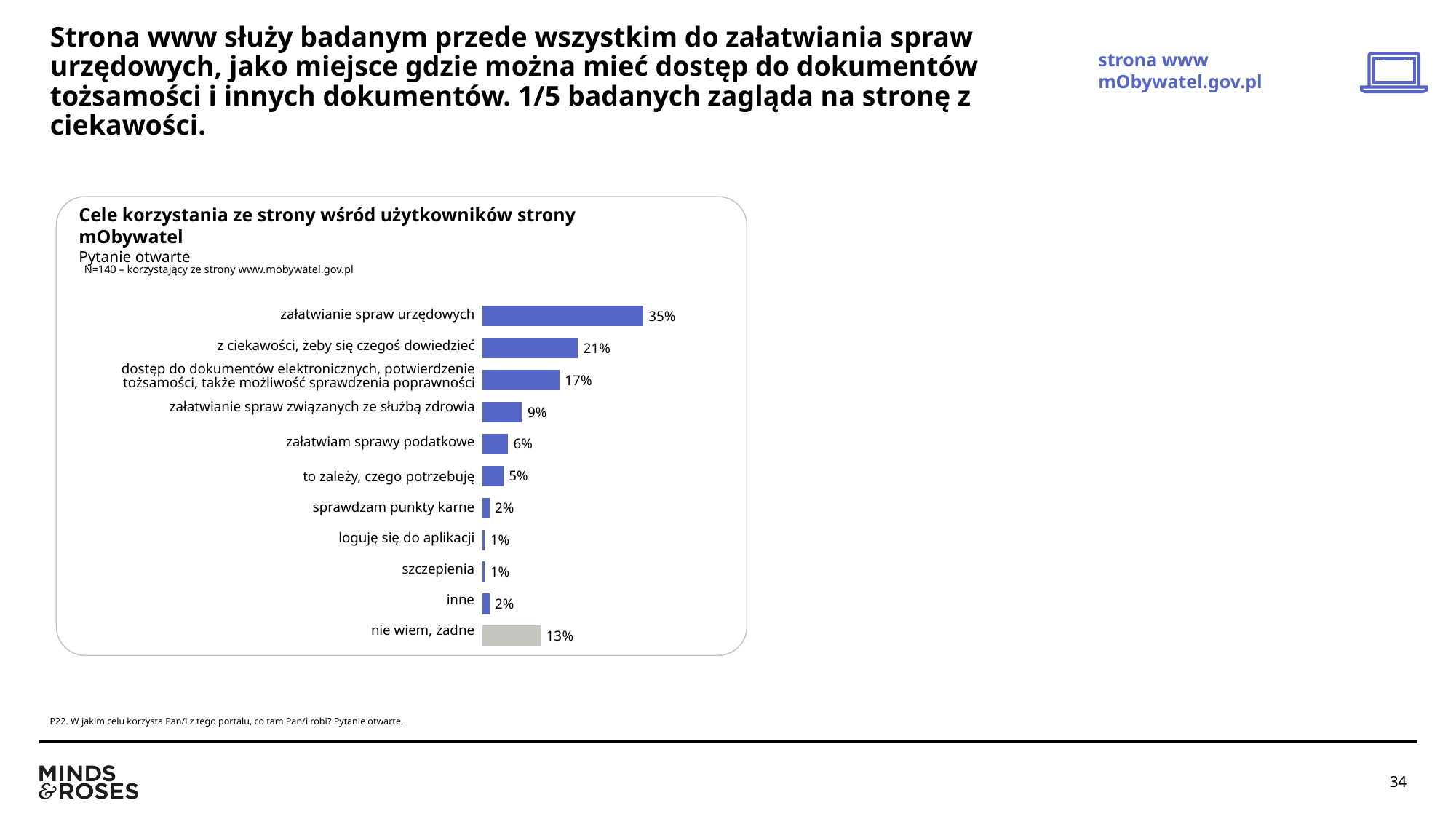
What is the value for "załatwianie spraw urzędowych"? 35% What is the difference between "załatwianie spraw urzędowych" and "z ciekawości, żeby się czegoś dowiedzieć"? 14% Which bar is shown in grey rather than blue? nie wiem, żadne Which is larger: "nie wiem, żadne" or "załatwianie spraw związanych ze służbą zdrowia"? nie wiem, żadne What is the difference between "dostęp do dokumentów elektronicznych, potwierdzenie tożsamości, także możliwość sprawdzenia poprawności" and "załatwiam sprawy podatkowe"? 11% How many categories are shown in the chart? 11 Which is larger: "to zależy, czego potrzebuję" or "sprawdzam punkty karne"? to zależy, czego potrzebuję What is the value for "załatwianie spraw związanych ze służbą zdrowia"? 9% Which category has the highest value? załatwianie spraw urzędowych What is the value for "nie wiem, żadne"? 13% What is the value for "z ciekawości, żeby się czegoś dowiedzieć"? 21% What kind of chart is shown on the slide? bar chart